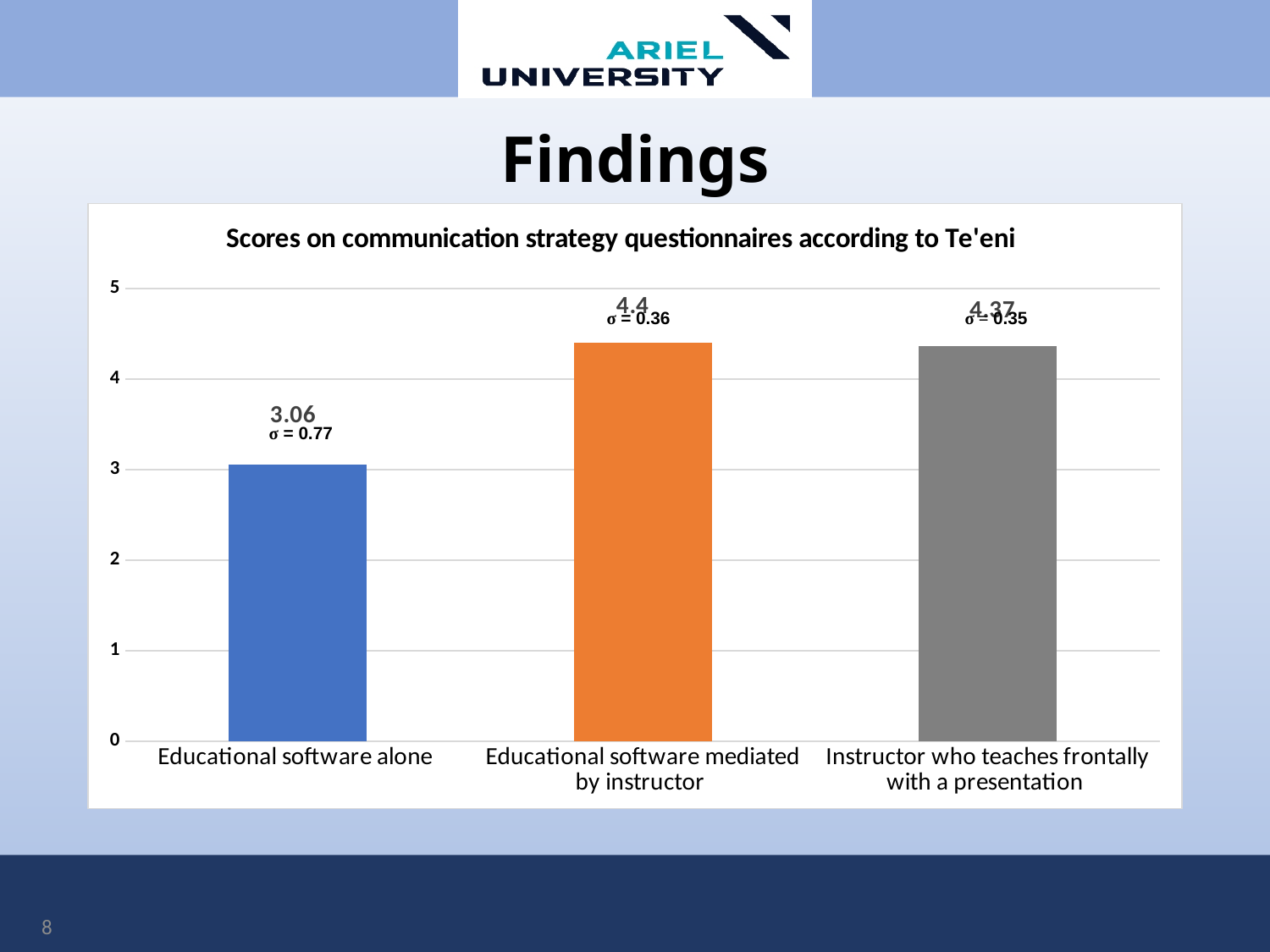
What is the difference between the scores for Educational software mediated by instructor and Educational software alone? 1.34 How many categories are shown in the chart? 3 What is the score for Instructor who teaches frontally with a presentation? 4.37 What kind of chart is shown on the slide? Bar chart What is the score for Educational software mediated by instructor? 4.4 Which category has the lowest score? Educational software alone What is the difference between the scores for Instructor who teaches frontally with a presentation and Educational software alone? 1.31 What is the title of the chart? Scores on communication strategy questionnaires according to Te'eni Which is larger, the score for Educational software alone or the score for Instructor who teaches frontally with a presentation? Instructor who teaches frontally with a presentation Which category has the highest score? Educational software mediated by instructor What is the score for Educational software alone? 3.06 Is the value for Educational software mediated by instructor greater or less than 4? greater